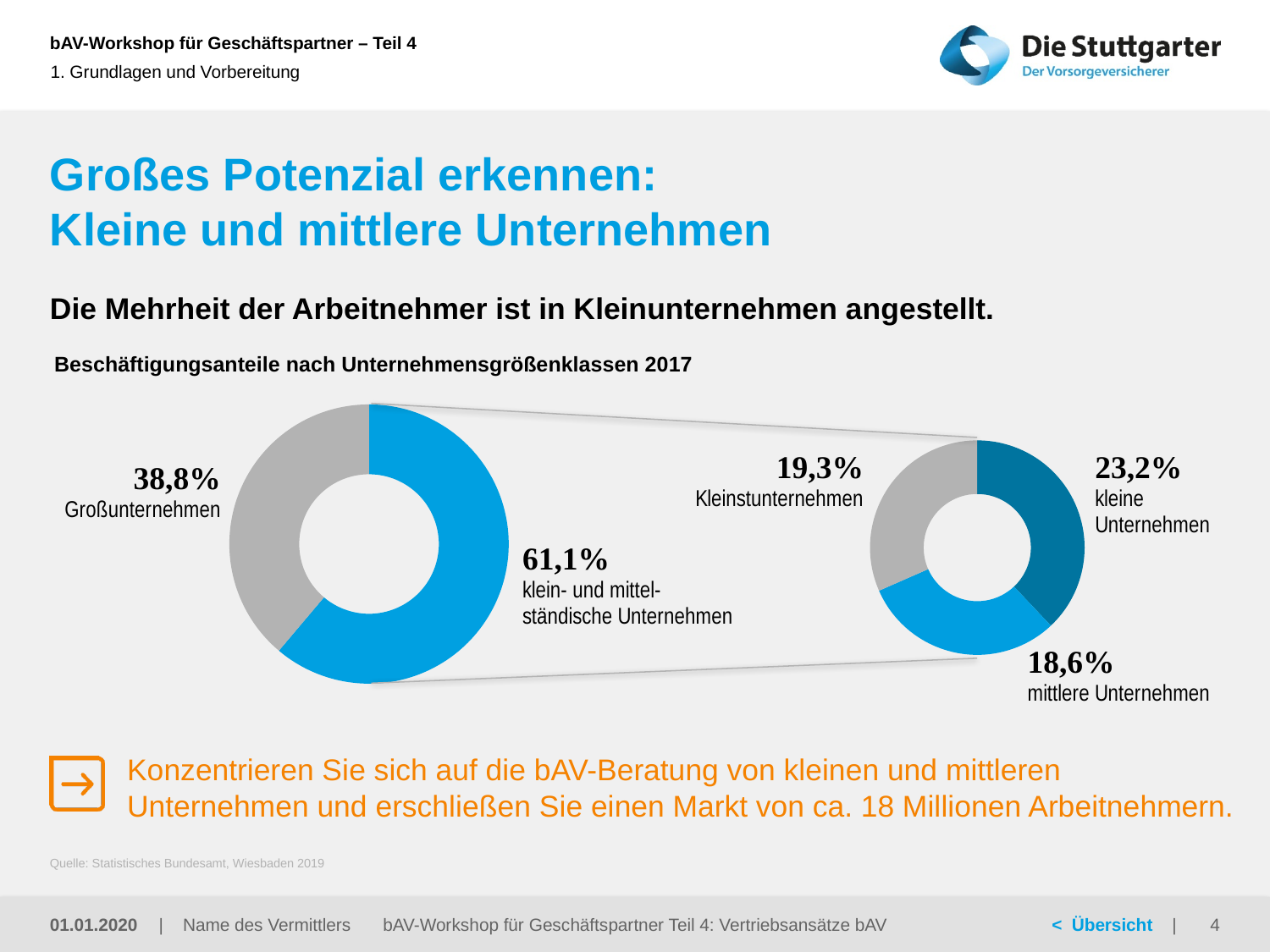
In the right donut chart, what share is shown for Kleinstunternehmen? 19,3% How many segments does the right donut chart have? 3 In the left donut chart, what share is shown for Großunternehmen? 38,8% In the left donut chart, what is the difference between the share for klein- und mittelständische Unternehmen and the share for Großunternehmen? 22,3 percentage points What is the title of the chart on the slide? Beschäftigungsanteile nach Unternehmensgrößenklassen 2017 In the right donut chart, which is larger: the share for Kleinstunternehmen or the share for mittlere Unternehmen? Kleinstunternehmen In the right donut chart, what share is shown for kleine Unternehmen? 23,2% In the right donut chart, which category has the largest share? kleine Unternehmen What type of chart is used on this slide? Donut (pie) chart In the right donut chart, what share is shown for mittlere Unternehmen? 18,6% In the left donut chart, what share of employees work in klein- und mittelständische Unternehmen? 61,1% In the right donut chart, which category has the smallest share? mittlere Unternehmen